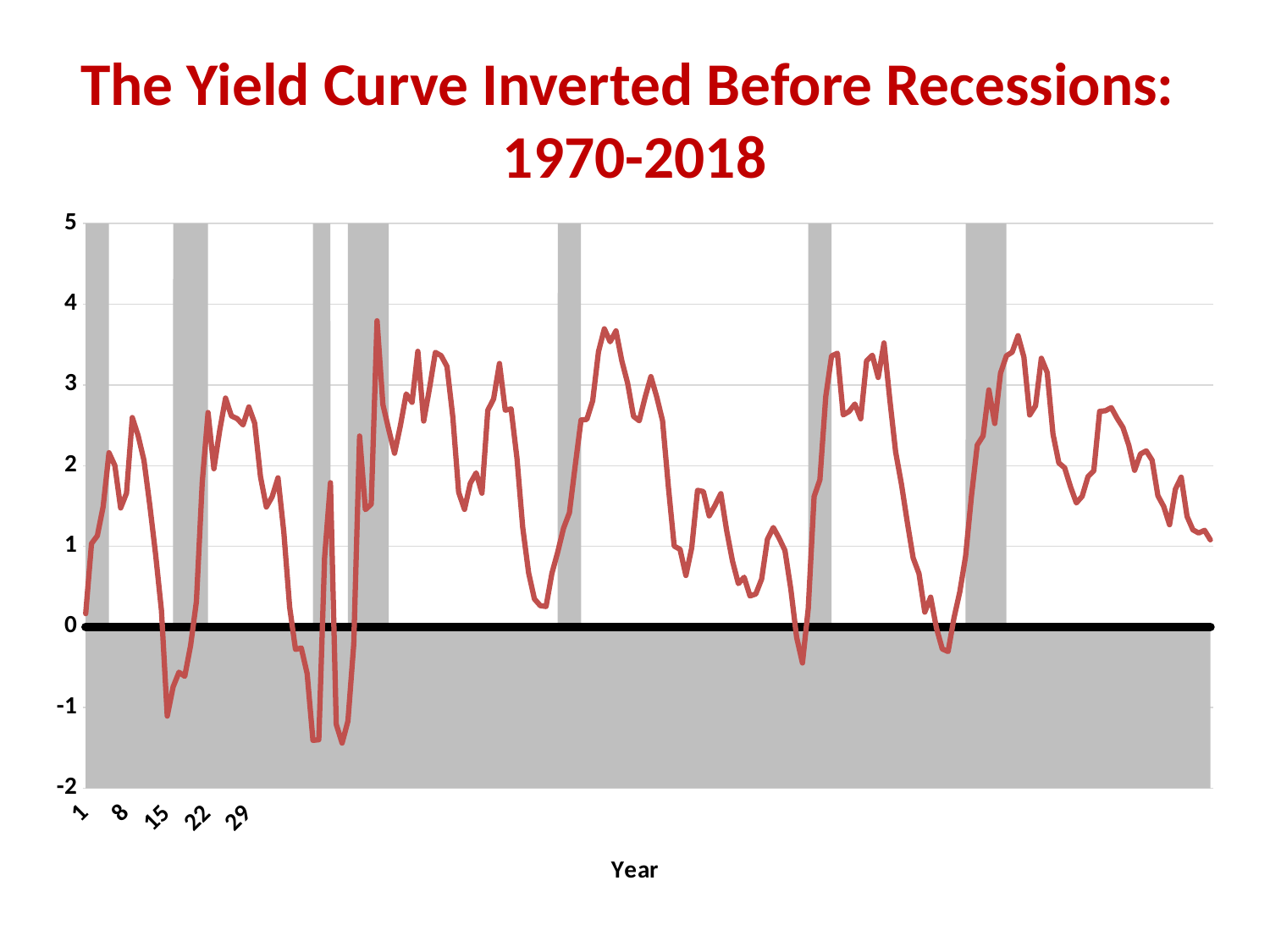
Between year 1 and year 8, does the line generally rise or fall? rise What kind of chart is shown on the slide? line chart Does the line ever fall below -1 on the vertical axis? yes What is the lowest value shown on the vertical axis? -2 Is the value of the line at year 29 greater or less than 2? greater Is the value of the line at year 15 greater or less than 0? less What is the highest value shown on the vertical axis? 5 Toward the right end of the chart, after the last peak, does the line rise or fall? fall What is the title of the chart on the slide? The Yield Curve Inverted Before Recessions: 1970-2018 What is the label on the horizontal axis of the chart? Year